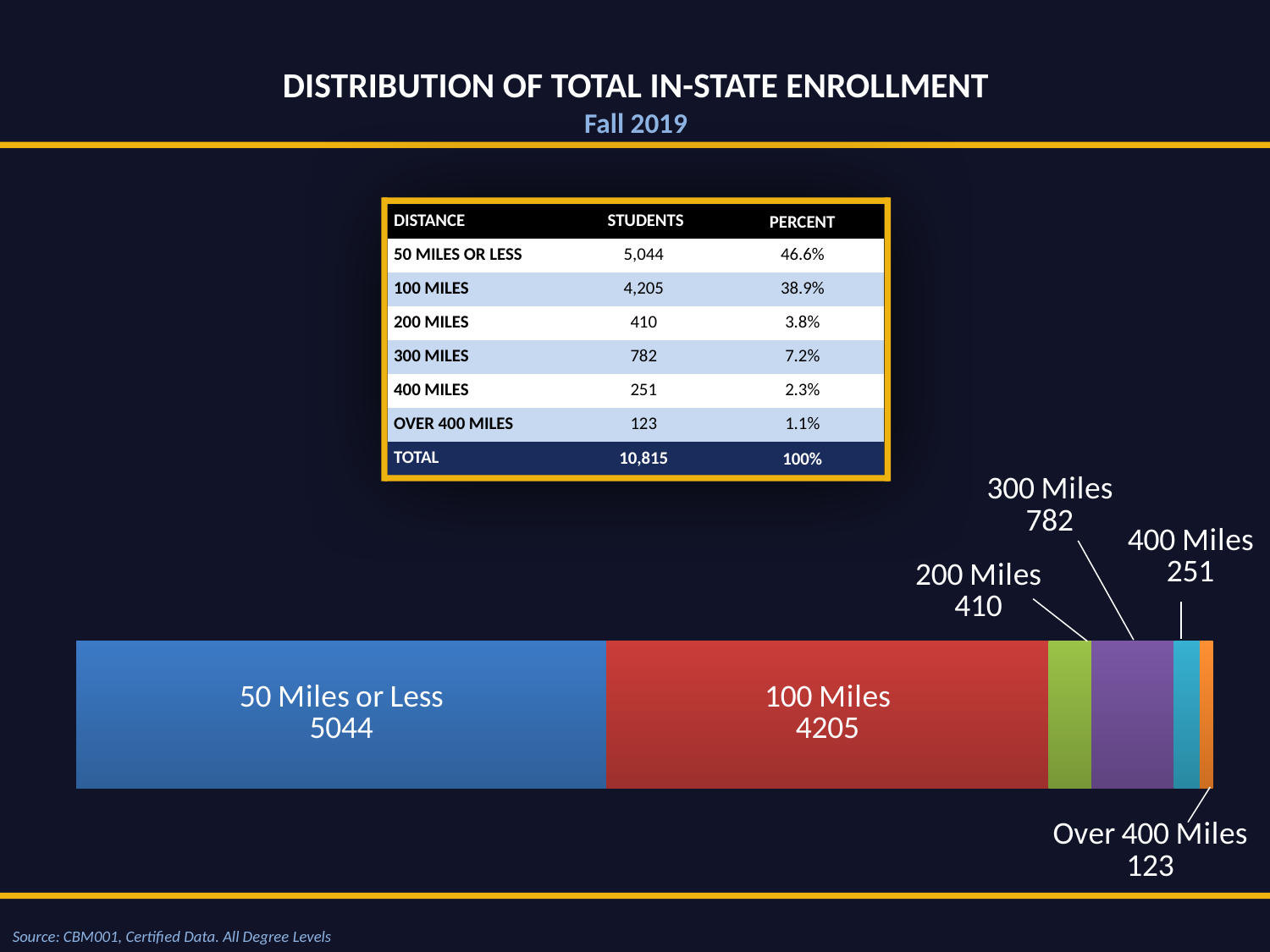
How many segments make up the stacked bar? 6 What value is shown for the 100 Miles segment of the stacked bar? 4205 What is the difference between the 300 Miles and 200 Miles values in the chart? 372 What value is shown for the Over 400 Miles segment of the stacked bar? 123 Which segment of the stacked bar has the largest value? 50 Miles or Less What colour is the 100 Miles segment of the stacked bar? Red What is the difference between the 50 Miles or Less and 100 Miles values in the chart? 839 What kind of chart is shown on the slide? Stacked bar chart Which segment of the stacked bar has the smallest value? Over 400 Miles What value is shown for the 300 Miles segment of the stacked bar? 782 What is the total of all segments in the stacked bar? 10815 Which is larger in the chart, the 200 Miles segment or the 400 Miles segment? 200 Miles